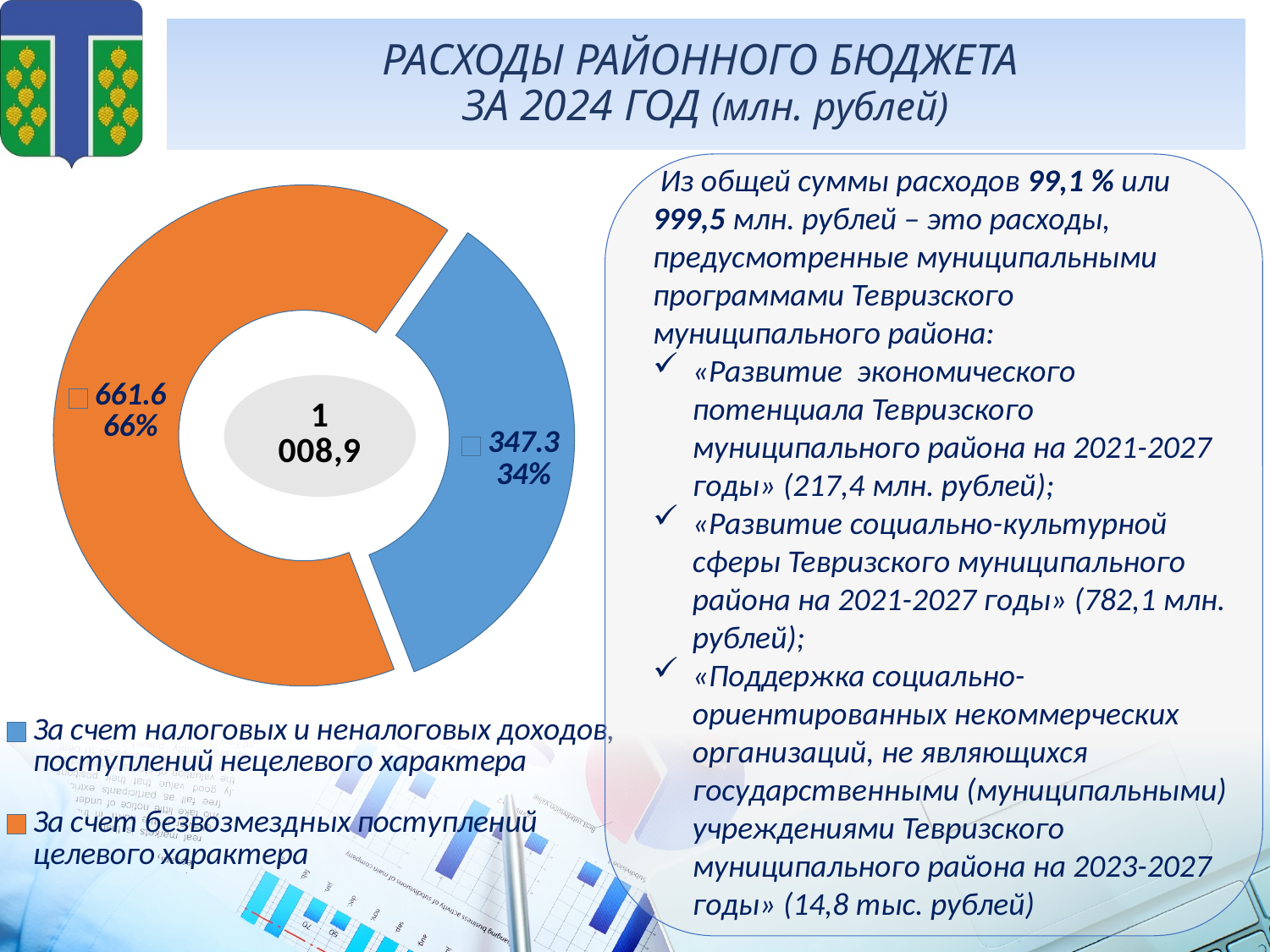
What is the value for «За счет безвозмездных поступлений целевого характера» (the orange slice)? 661.6 What share of the chart does the blue slice «За счет налоговых и неналоговых доходов, поступлений нецелевого характера» represent? 34% Which category has the largest slice in the chart? За счет безвозмездных поступлений целевого характера What is the value for «За счет налоговых и неналоговых доходов, поступлений нецелевого характера» (the blue slice)? 347.3 What total value is shown in the centre of the doughnut chart? 1 008,9 How many slices does the chart have? 2 Which category has the smallest slice in the chart? За счет налоговых и неналоговых доходов, поступлений нецелевого характера What is the difference between the orange slice value (661.6) and the blue slice value (347.3)? 314.3 Which is larger: the value for «За счет безвозмездных поступлений целевого характера» or the value for «За счет налоговых и неналоговых доходов, поступлений нецелевого характера»? За счет безвозмездных поступлений целевого характера What share of the chart does the orange slice «За счет безвозмездных поступлений целевого характера» represent? 66% Which colour represents «За счет налоговых и неналоговых доходов, поступлений нецелевого характера» in the chart? Blue What kind of chart is shown on the slide? Doughnut (pie) chart